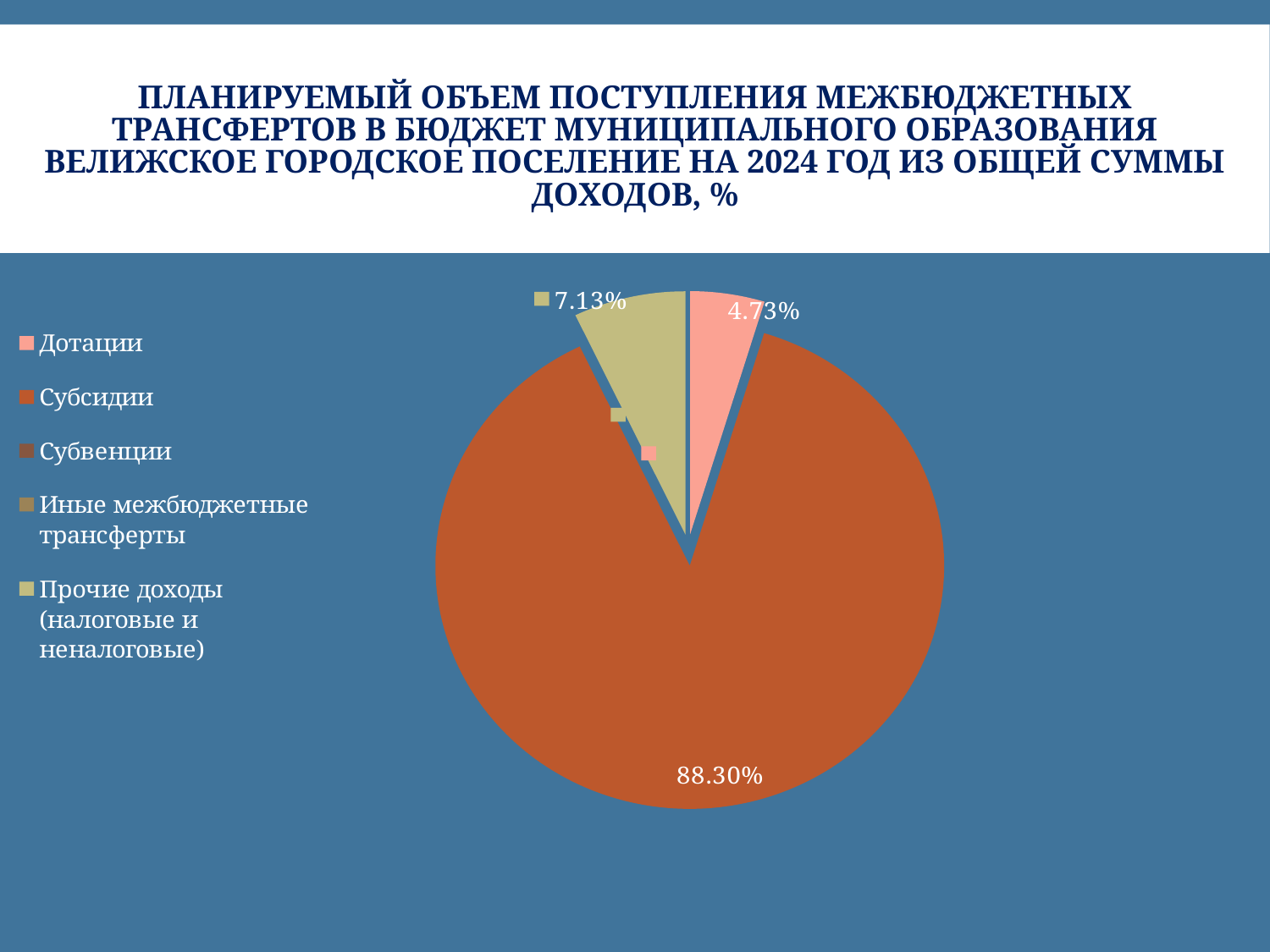
What is the difference between the share for Субсидии and the share for Дотации? 83.57% Is the share for Субсидии greater or less than 50%? greater Which category has the largest share of the pie? Субсидии What type of chart is shown on the slide? Pie chart Which is larger, the share for Дотации or the share for Прочие доходы (налоговые и неналоговые)? Прочие доходы (налоговые и неналоговые) What percentage is shown for Субсидии? 88.30% What is the difference between the share for Прочие доходы (налоговые и неналоговые) and the share for Дотации? 2.40% How many categories does the legend list? 5 Which year does the chart title refer to? 2024 What percentage is shown for Прочие доходы (налоговые и неналоговые)? 7.13% What percentage is shown for Дотации? 4.73% Which category is labelled 4.73% on the pie? Дотации